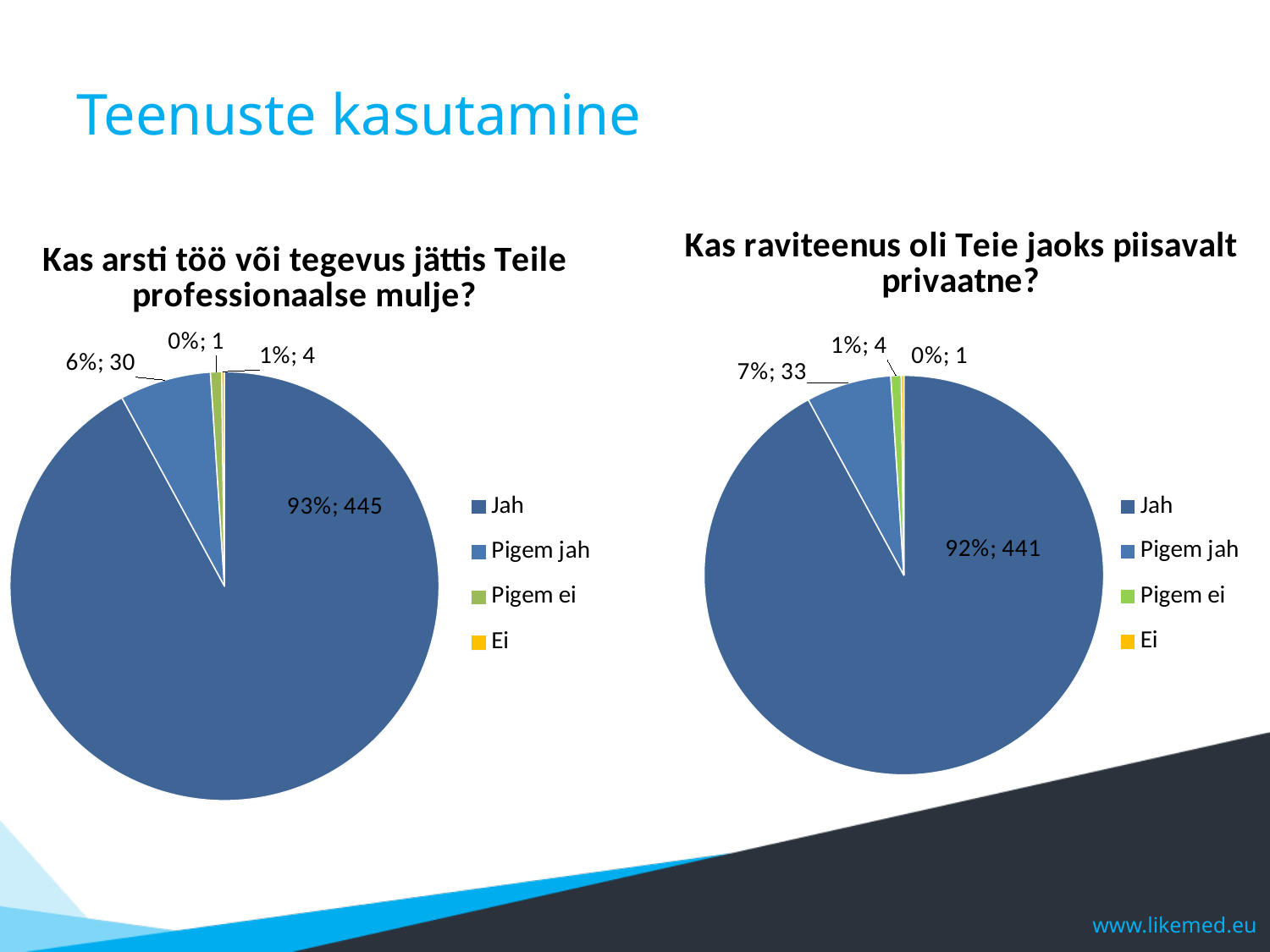
What type of chart is used on the left side of the slide? Pie chart On the right chart ("Kas raviteenus oli Teie jaoks piisavalt privaatne?"), what value is shown for Pigem jah? 7%; 33 On the left chart ("Kas arsti töö või tegevus jättis Teile professionaalse mulje?"), which category has the largest slice? Jah On the right chart ("Kas raviteenus oli Teie jaoks piisavalt privaatne?"), which category has the smallest slice? Ei On the left chart ("Kas arsti töö või tegevus jättis Teile professionaalse mulje?"), what value is shown for Jah? 93%; 445 On the left chart ("Kas arsti töö või tegevus jättis Teile professionaalse mulje?"), what share of the pie does Jah take? 93% On the right chart ("Kas raviteenus oli Teie jaoks piisavalt privaatne?"), what value is shown for Jah? 92%; 441 How many categories does the legend of the right chart ("Kas raviteenus oli Teie jaoks piisavalt privaatne?") list? 4 Which is larger: the Pigem jah count on the left chart or the Pigem jah count on the right chart? Right chart (33) On the right chart ("Kas raviteenus oli Teie jaoks piisavalt privaatne?"), what value is shown for Pigem ei? 1%; 4 On the left chart ("Kas arsti töö või tegevus jättis Teile professionaalse mulje?"), what value is shown for Pigem jah? 6%; 30 What is the difference in count between Jah on the left chart (445) and Jah on the right chart (441)? 4